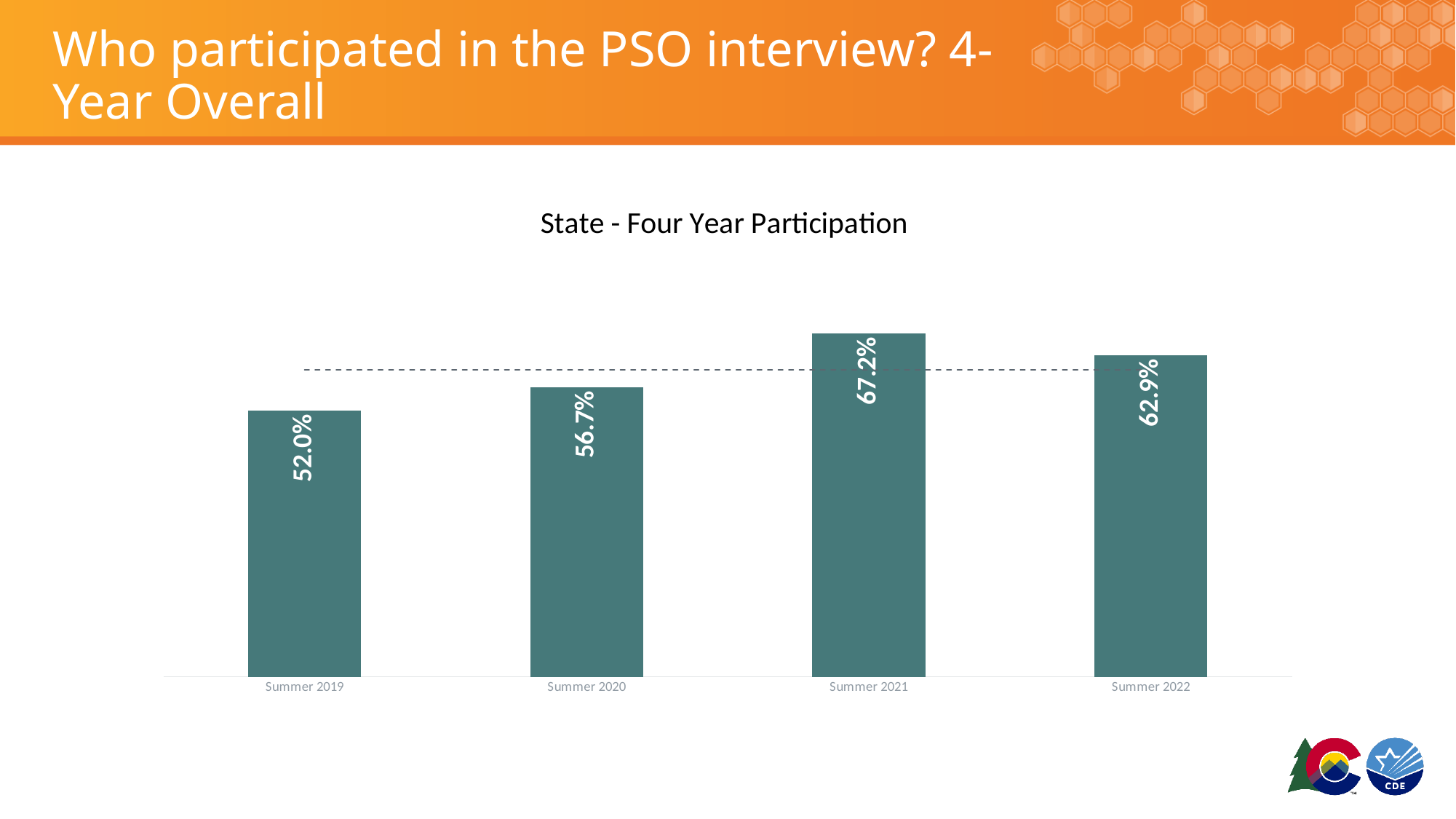
What is the participation value for Summer 2019? 52.0% What is the participation value for Summer 2022? 62.9% Which category has the highest participation value? Summer 2021 What is the participation value for Summer 2020? 56.7% What is the participation value for Summer 2021? 67.2% What is the difference between the Summer 2021 and Summer 2019 values? 15.2% Which category has the lowest participation value? Summer 2019 What is the difference between the Summer 2022 and Summer 2020 values? 6.2% What is the title of the chart? State - Four Year Participation Which is larger, the value for Summer 2020 or the value for Summer 2022? Summer 2022 What kind of chart is shown on the slide? Bar chart How many categories are shown on the x axis? 4